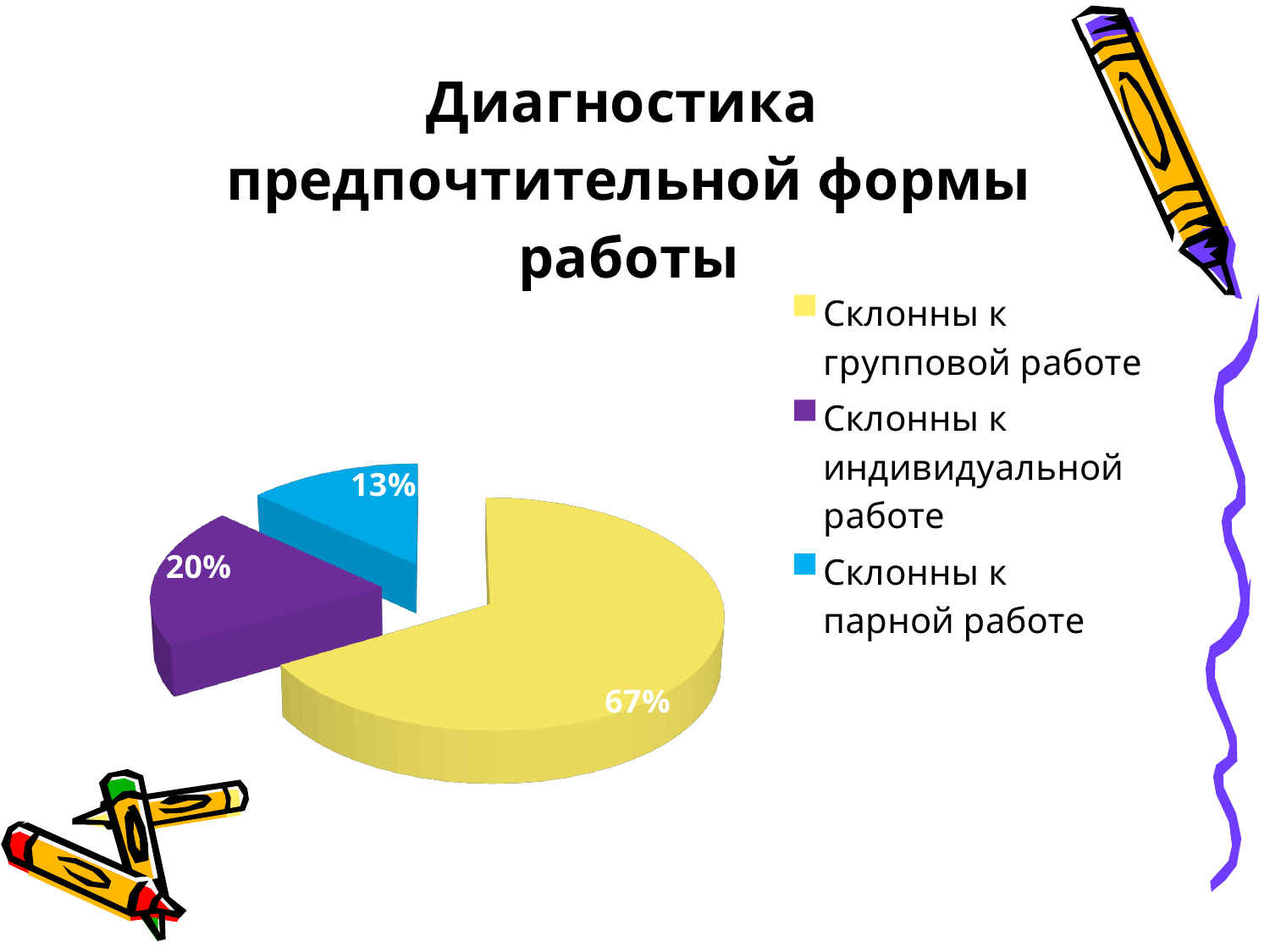
What colour is the slice for 'Склонны к парной работе'? Blue How many entries does the legend list? 3 Which is larger: the share for 'Склонны к индивидуальной работе' or for 'Склонны к парной работе'? Склонны к индивидуальной работе What share of the pie is labelled 'Склонны к индивидуальной работе'? 20% What kind of chart is shown on the slide? Pie chart What share of the pie is labelled 'Склонны к групповой работе'? 67% What is the difference in percentage points between 'Склонны к индивидуальной работе' and 'Склонны к парной работе'? 7 How many slices does the pie chart have? 3 Which category has the largest slice of the pie? Склонны к групповой работе What is the difference in percentage points between 'Склонны к групповой работе' and 'Склонны к индивидуальной работе'? 47 What share of the pie is labelled 'Склонны к парной работе'? 13% Which category has the smallest slice of the pie? Склонны к парной работе